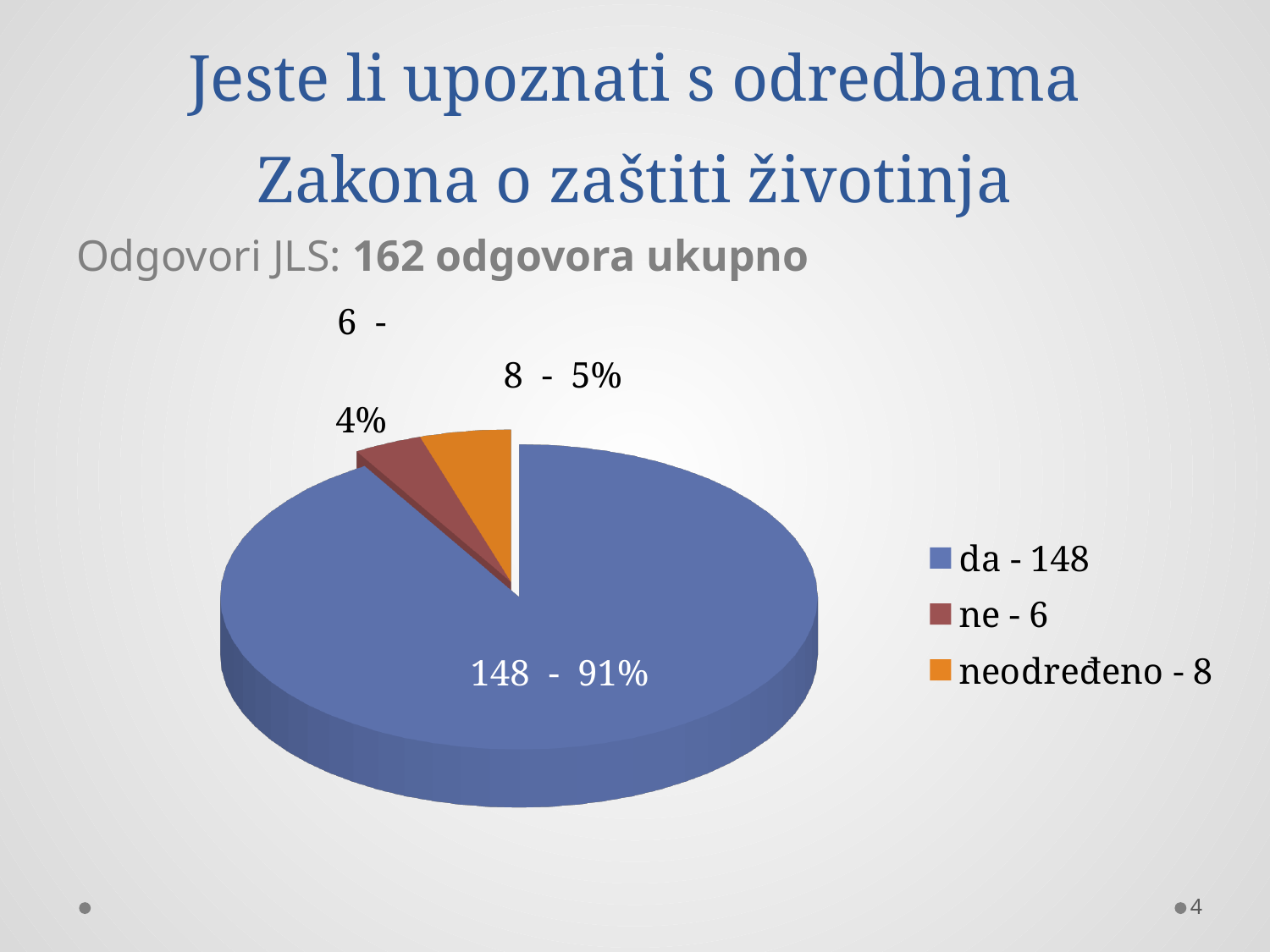
How many responses are in the "neodređeno" slice? 8 How many slices does the pie chart have? 3 Which slice is larger, "ne" or "neodređeno"? neodređeno What kind of chart is shown on the slide? pie chart What is the difference between the number of "da" responses and "neodređeno" responses? 140 What share of the pie does the "da" slice represent? 91% How many responses are in the "da" slice? 148 Which category has the smallest slice? ne How many responses are in the "ne" slice? 6 What share of the pie does the "neodređeno" slice represent? 5% How many entries does the legend list? 3 Which category has the largest slice? da